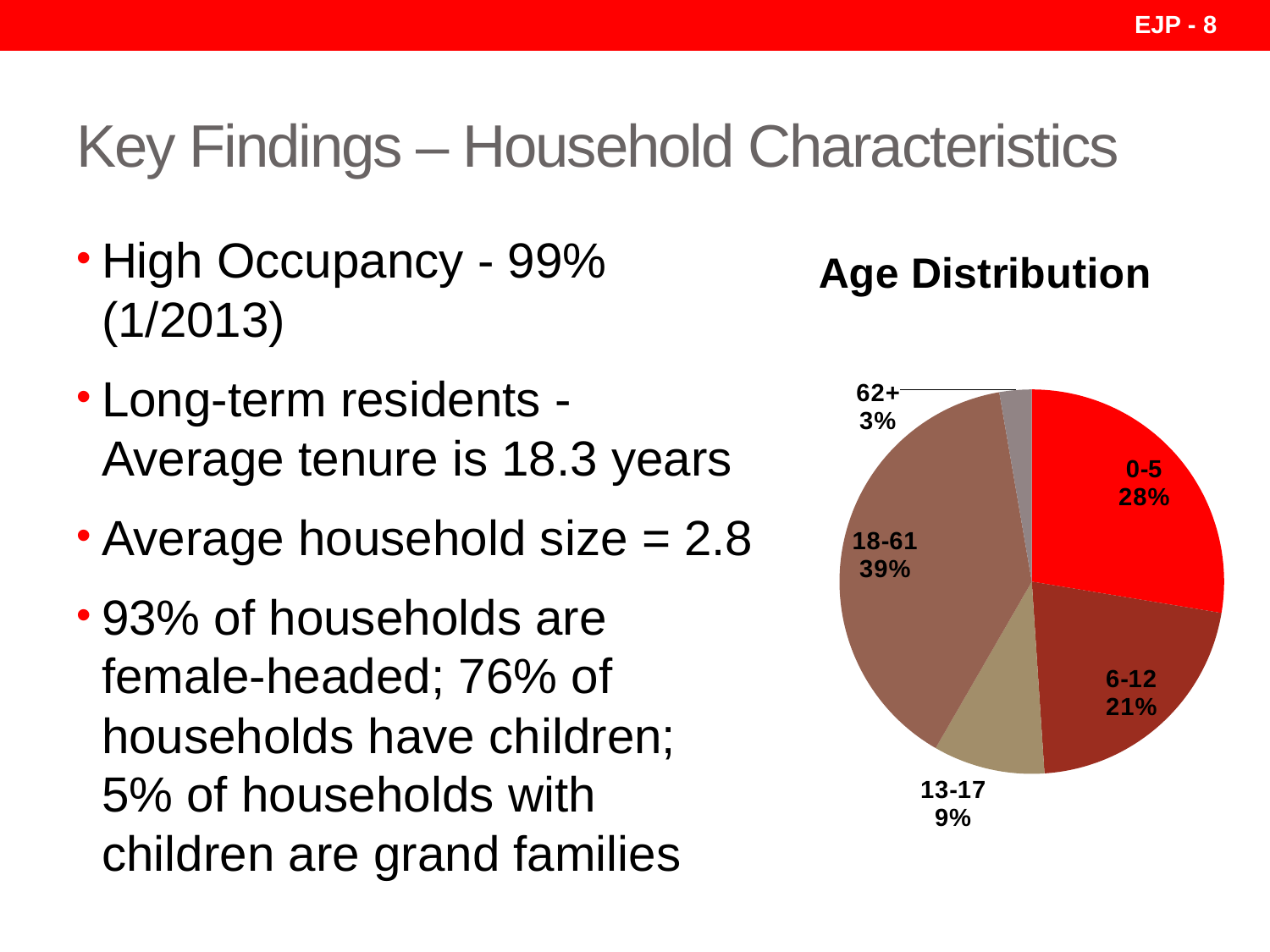
What percentage is shown for the 18-61 age group? 39% Which age group has a larger share, 6-12 or 13-17? 6-12 What percentage is shown for the 62+ age group? 3% What share of the pie does the 0-5 age group represent? 28% What percentage is shown for the 13-17 age group? 9% How many age groups are shown in the pie chart? 5 What is the difference in percentage points between the 18-61 and 62+ age groups? 36 What kind of chart is shown on the slide? pie chart What is the title of the chart? Age Distribution Which age group has the largest share of the pie? 18-61 What is the difference in percentage points between the 0-5 and 6-12 age groups? 7 Which age group has the smallest share of the pie? 62+